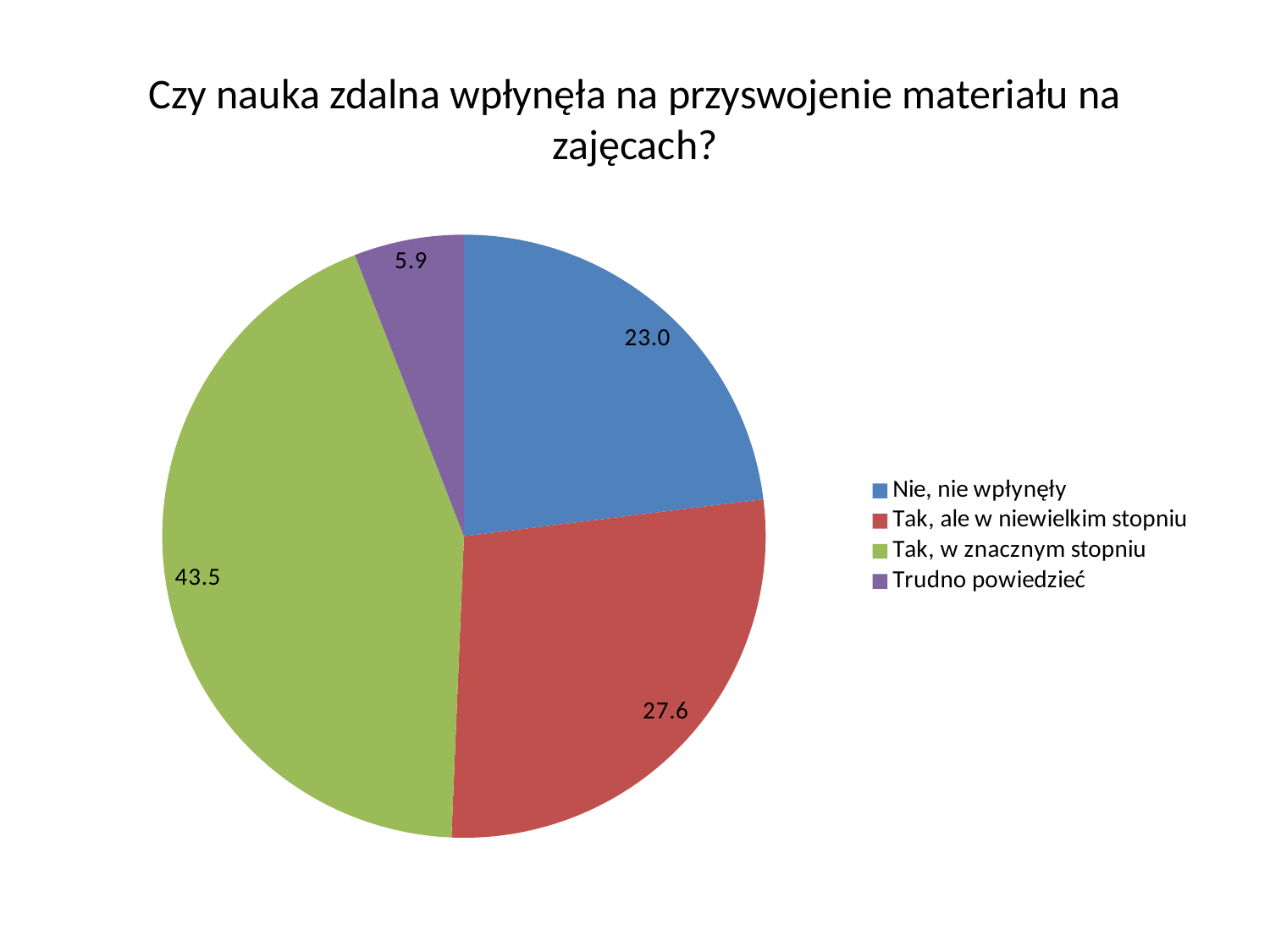
What is the value for "Trudno powiedzieć"? 5.9 What is the value for "Tak, ale w niewielkim stopniu"? 27.6 What is the value for "Nie, nie wpłynęły"? 23.0 What is the value for "Tak, w znacznym stopniu"? 43.5 How many slices does the pie chart have? 4 What is the title of the chart? Czy nauka zdalna wpłynęła na przyswojenie materiału na zajęcach? Which category has the largest slice? Tak, w znacznym stopniu What is the difference between the values for "Tak, w znacznym stopniu" and "Nie, nie wpłynęły"? 20.5 What kind of chart is shown on the slide? pie chart Which category has the smallest slice? Trudno powiedzieć What colour is the slice for "Tak, w znacznym stopniu"? green Which is larger: "Tak, ale w niewielkim stopniu" or "Nie, nie wpłynęły"? Tak, ale w niewielkim stopniu